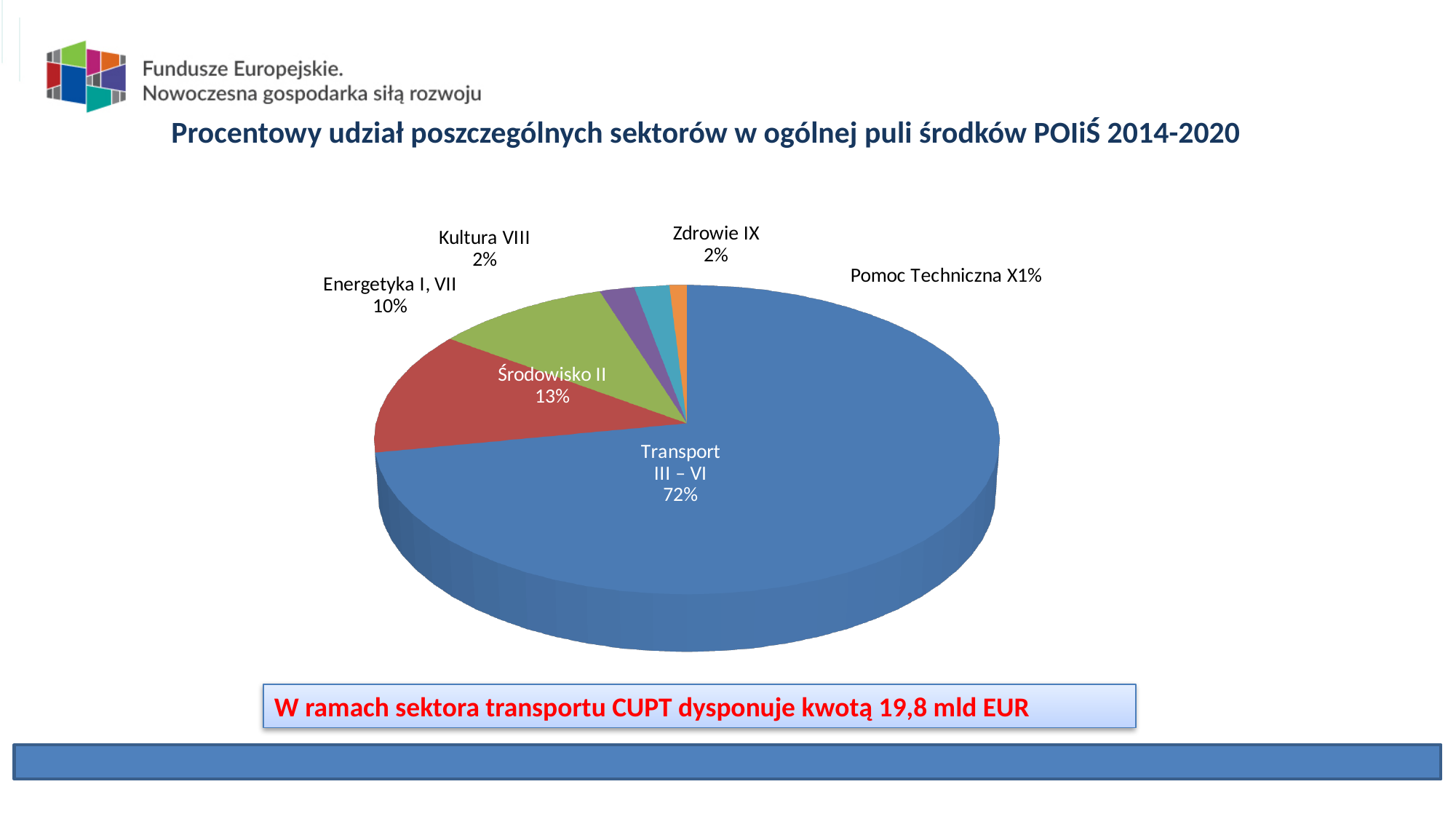
Which sector has the largest share of the pie? Transport III – VI What percentage is shown for Środowisko II? 13% What share of the pie does Transport III – VI have? 72% What is the title of the chart? Procentowy udział poszczególnych sektorów w ogólnej puli środków POIiŚ 2014-2020 What percentage is shown for Pomoc Techniczna X? 1% What type of chart is shown on the slide? Pie chart What percentage is shown for Energetyka I, VII? 10% Which has a larger share, Środowisko II or Energetyka I, VII? Środowisko II How many sectors (slices) are shown in the pie chart? 6 Which sector has the smallest share of the pie? Pomoc Techniczna X What percentage is shown for Kultura VIII? 2% What is the difference in percentage points between Transport III – VI and Środowisko II? 59